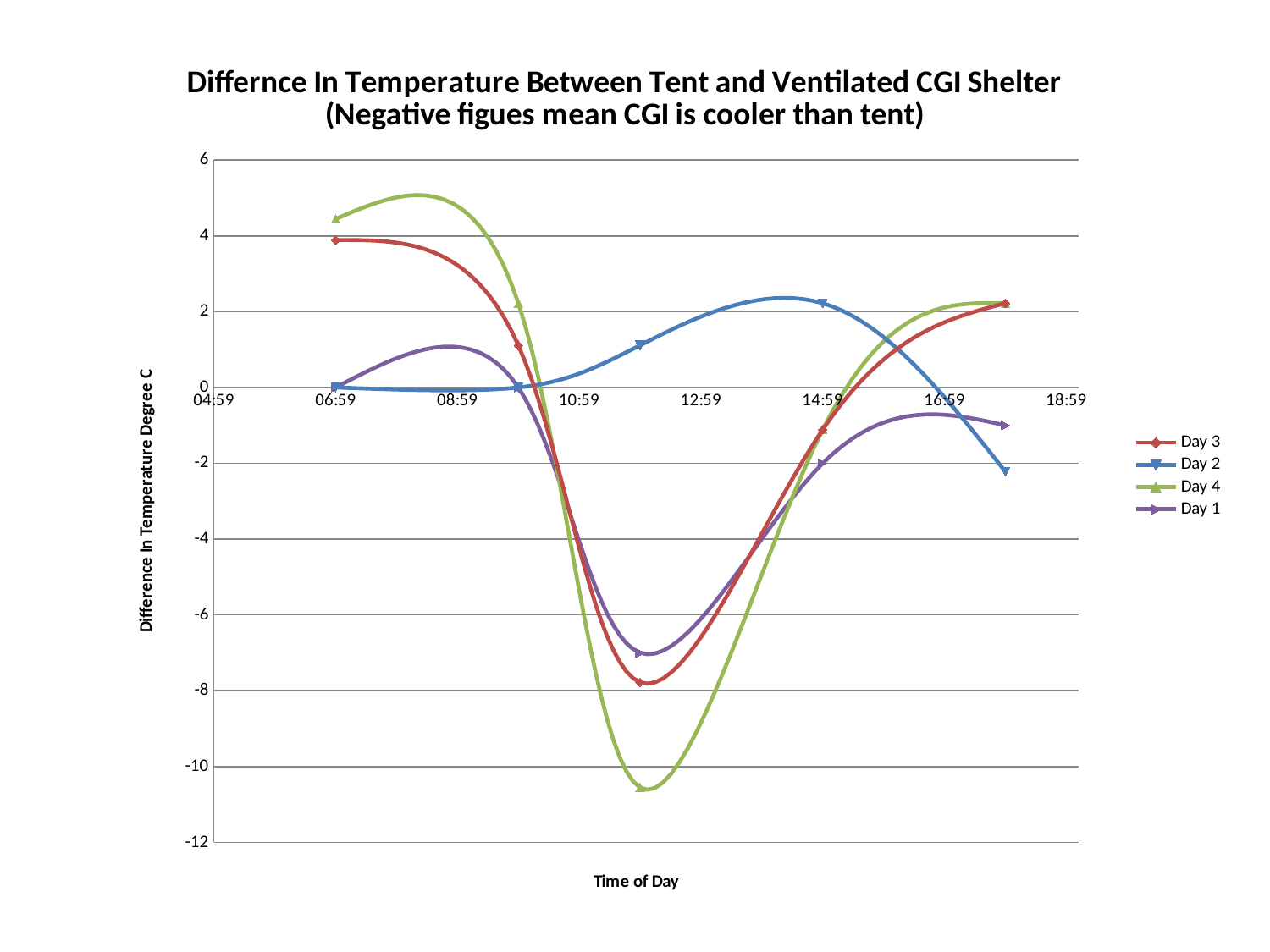
Is the value for Day 4 at 11:59 greater or less than -10? less Is the value for Day 2 at 17:59 greater or less than 0? less How many series does the legend list? 4 Is the value for Day 4 at 06:59 greater or less than 4? greater At 14:59, which is larger: the value for Day 2 or the value for Day 1? Day 2 How many data points are plotted for each series? 5 What kind of chart is shown on the slide? line chart At 11:59, which is larger: the value for Day 3 or the value for Day 4? Day 3 What is the title of the vertical axis? Difference In Temperature Degree C Which series reaches the lowest value on the chart? Day 4